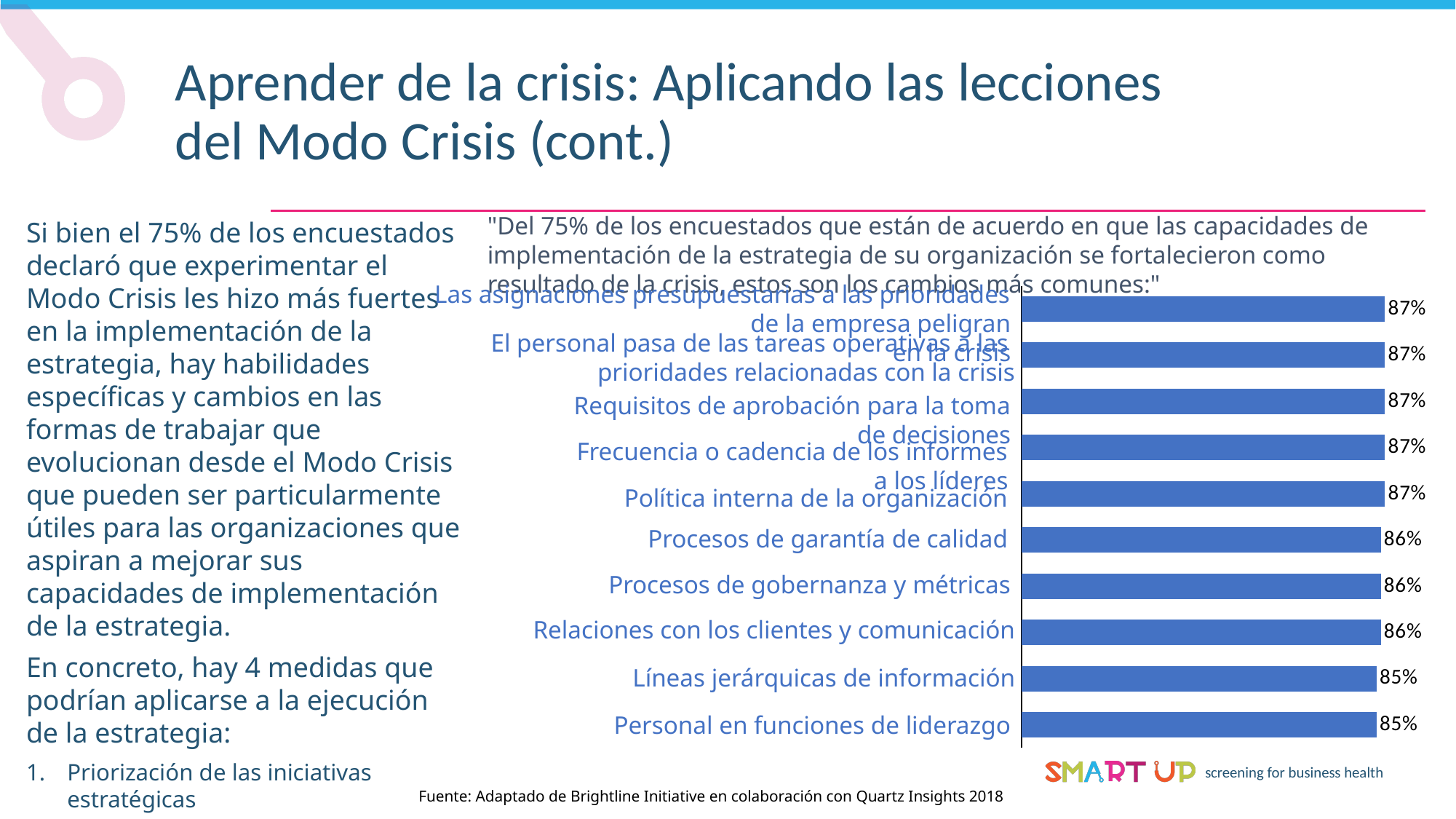
What value is shown for "Relaciones con los clientes y comunicación"? 86% How many categories are plotted in the chart? 10 What value is shown for "Personal en funciones de liderazgo"? 85% What value is shown for "Procesos de garantía de calidad"? 86% What value is shown for "Requisitos de aprobación para la toma de decisiones"? 87% What is the difference between the values for "Política interna de la organización" and "Personal en funciones de liderazgo"? 2 percentage points What kind of chart is shown on the slide? Bar chart What colour are the bars in the chart? Blue What value is shown for "Líneas jerárquicas de información"? 85% Which has a larger value: "Procesos de gobernanza y métricas" or "Líneas jerárquicas de información"? Procesos de gobernanza y métricas What value is shown for "Política interna de la organización"? 87% Do the values rise or fall going from the top bar to the bottom bar? Fall